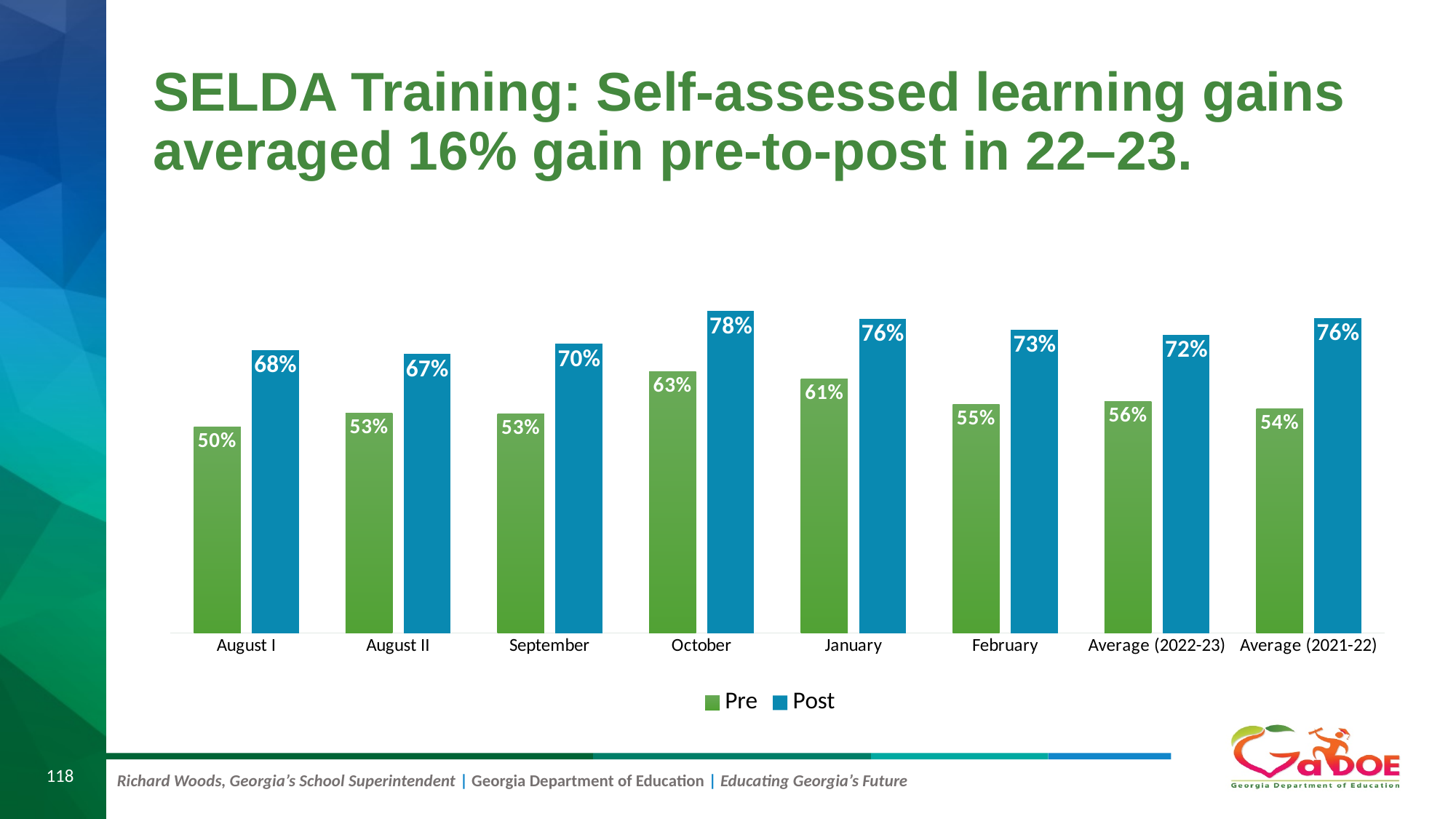
Which category has the highest Post value? October How many series does the legend list? 2 What is the Post value for Average (2021-22)? 76% What is the Pre value for October? 63% What is the difference between the Post values for Average (2022-23) and Average (2021-22)? 4% What are the two series named in the legend? Pre and Post What kind of chart is shown on the slide? Bar chart How many categories are shown on the x axis? 8 What is the difference between the Post and Pre values for January? 15% Which is larger, the Pre value for February or the Pre value for September? February Which category has the lowest Pre value? August I What is the Post value for August II? 67%